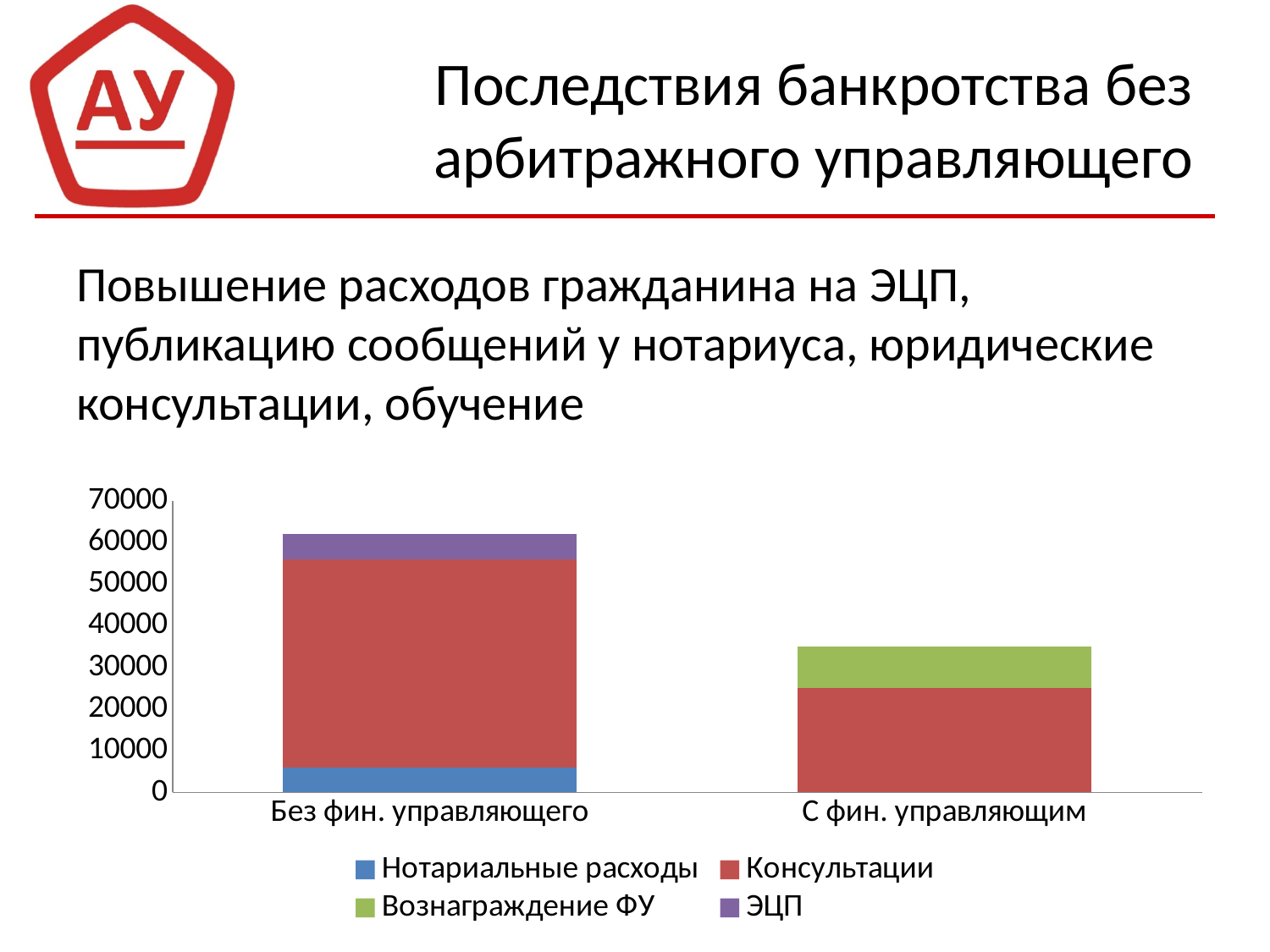
What colour represents the "Консультации" series in the chart? Red Is the total value of the bar for "Без фин. управляющего" greater or less than 50000? greater What is the maximum value shown on the vertical axis of the chart? 70000 Is the total value of the bar for "С фин. управляющим" greater or less than 30000? greater Is the "Нотариальные расходы" segment for "Без фин. управляющего" greater or less than 10000? less Which series appears only in the "С фин. управляющим" bar? Вознаграждение ФУ Which category has the taller stacked bar, "Без фин. управляющего" or "С фин. управляющим"? Без фин. управляющего How many categories are shown on the x axis of the chart? 2 Which category has the lowest total stacked bar? С фин. управляющим How many series does the chart legend list? 4 What kind of chart is shown on the slide? Stacked bar chart